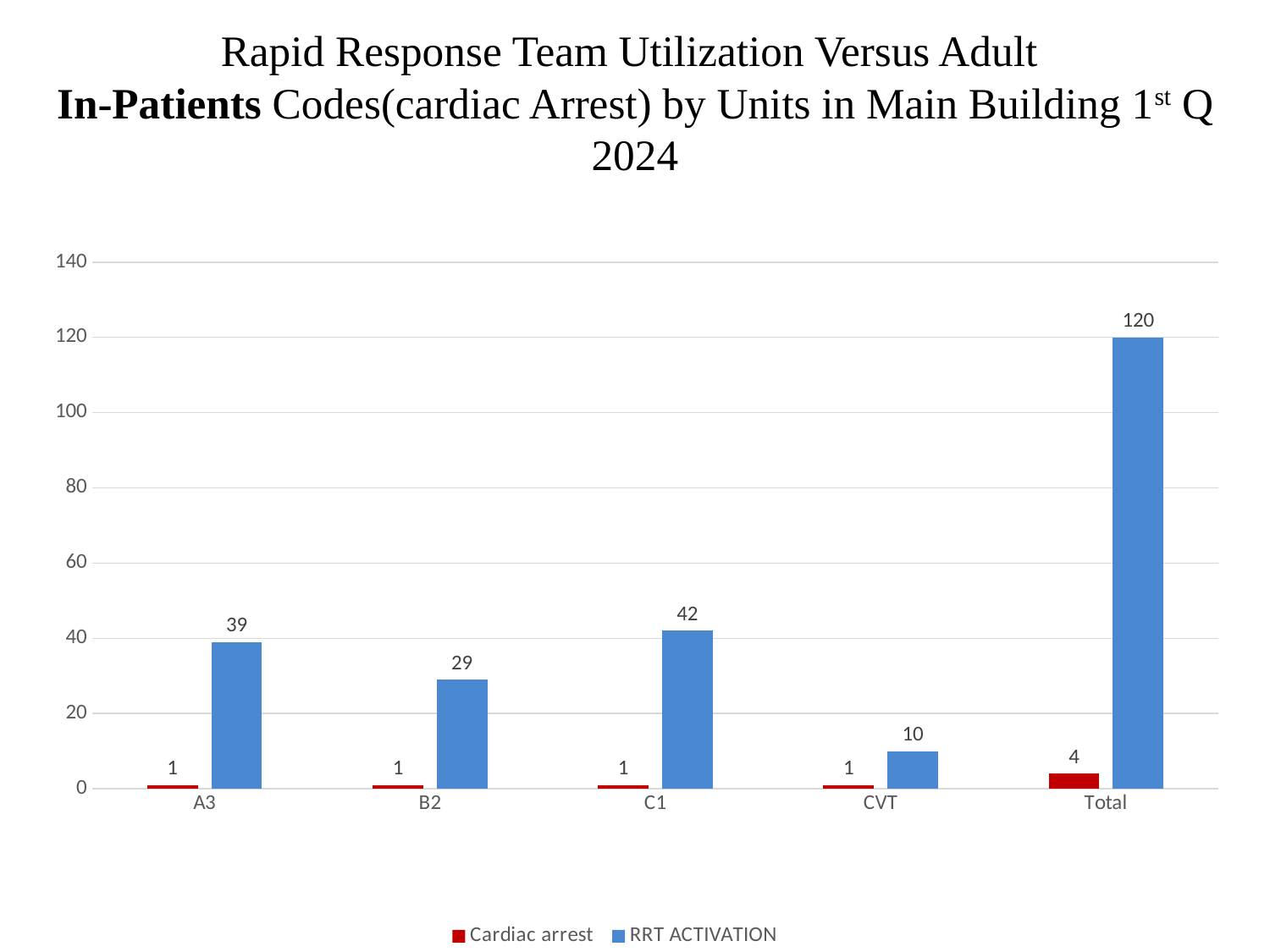
What kind of chart is shown on the slide? bar chart What is the Cardiac arrest value for Total? 4 How many series does the legend list? 2 Which category has the lowest RRT ACTIVATION value? CVT What is the RRT ACTIVATION value for C1? 42 What is the RRT ACTIVATION value for CVT? 10 Which unit (excluding Total) has the highest RRT ACTIVATION value? C1 What colour are the Cardiac arrest bars? red What is the difference between the RRT ACTIVATION values for A3 and B2? 10 Which is larger, the RRT ACTIVATION value for B2 or for CVT? B2 Is the RRT ACTIVATION value for Total greater or less than 100? greater How many categories are shown on the x axis? 5